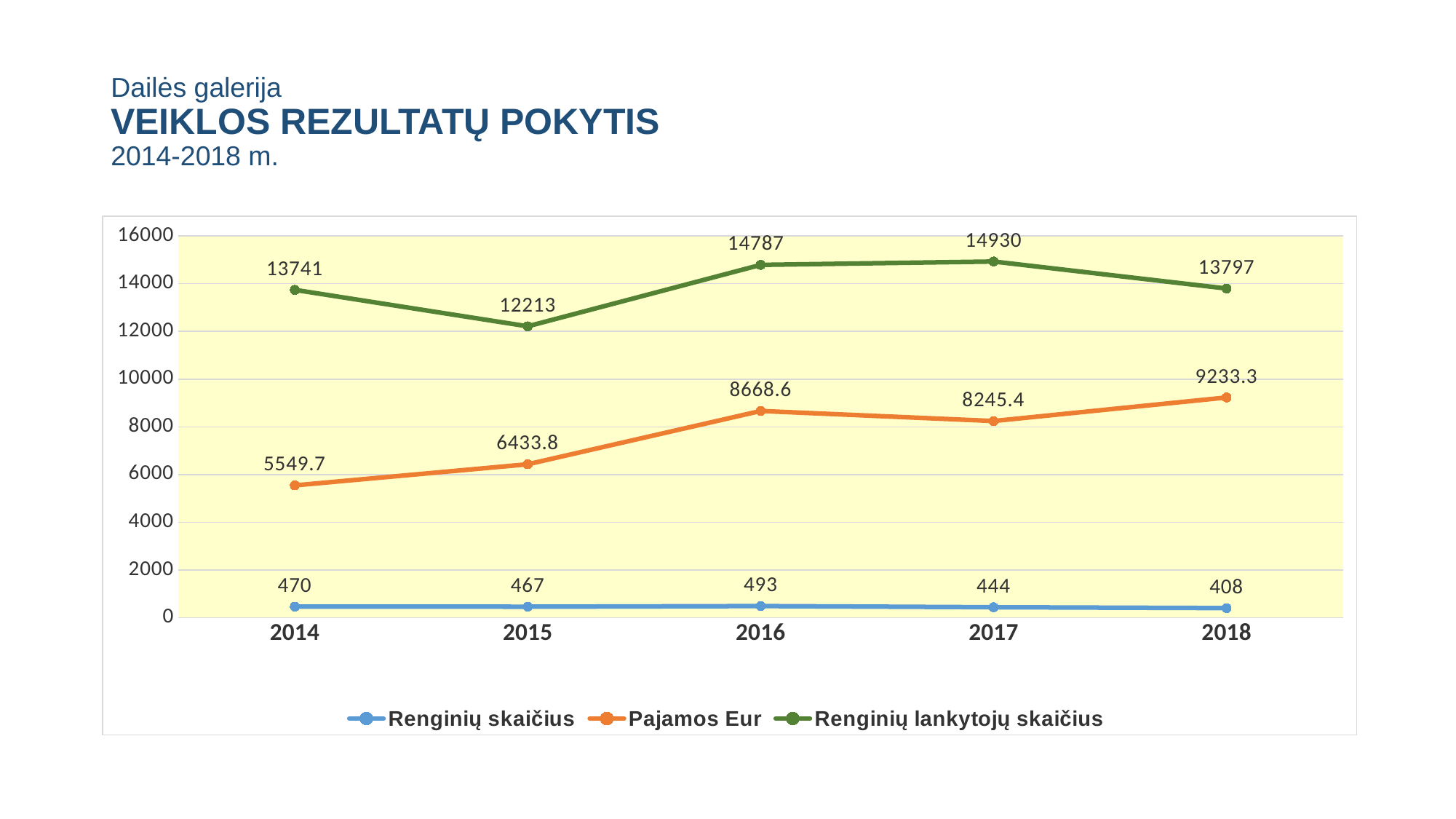
What kind of chart is shown on the slide? line chart What is the value of Pajamos Eur in 2016? 8668.6 Is the value of Pajamos Eur in 2017 greater or less than 8000? greater How many years are shown on the x axis? 5 Does Pajamos Eur rise or fall from 2014 to 2016? rise What is the value of Renginių skaičius in 2018? 408 What is the difference between Pajamos Eur in 2018 and in 2014? 3683.6 Which is larger: Renginių lankytojų skaičius in 2014 or in 2018? 2018 What is the value of Renginių lankytojų skaičius in 2015? 12213 In which year is Renginių skaičius lowest? 2018 How many series does the legend list? 3 In which year is Renginių lankytojų skaičius highest? 2017